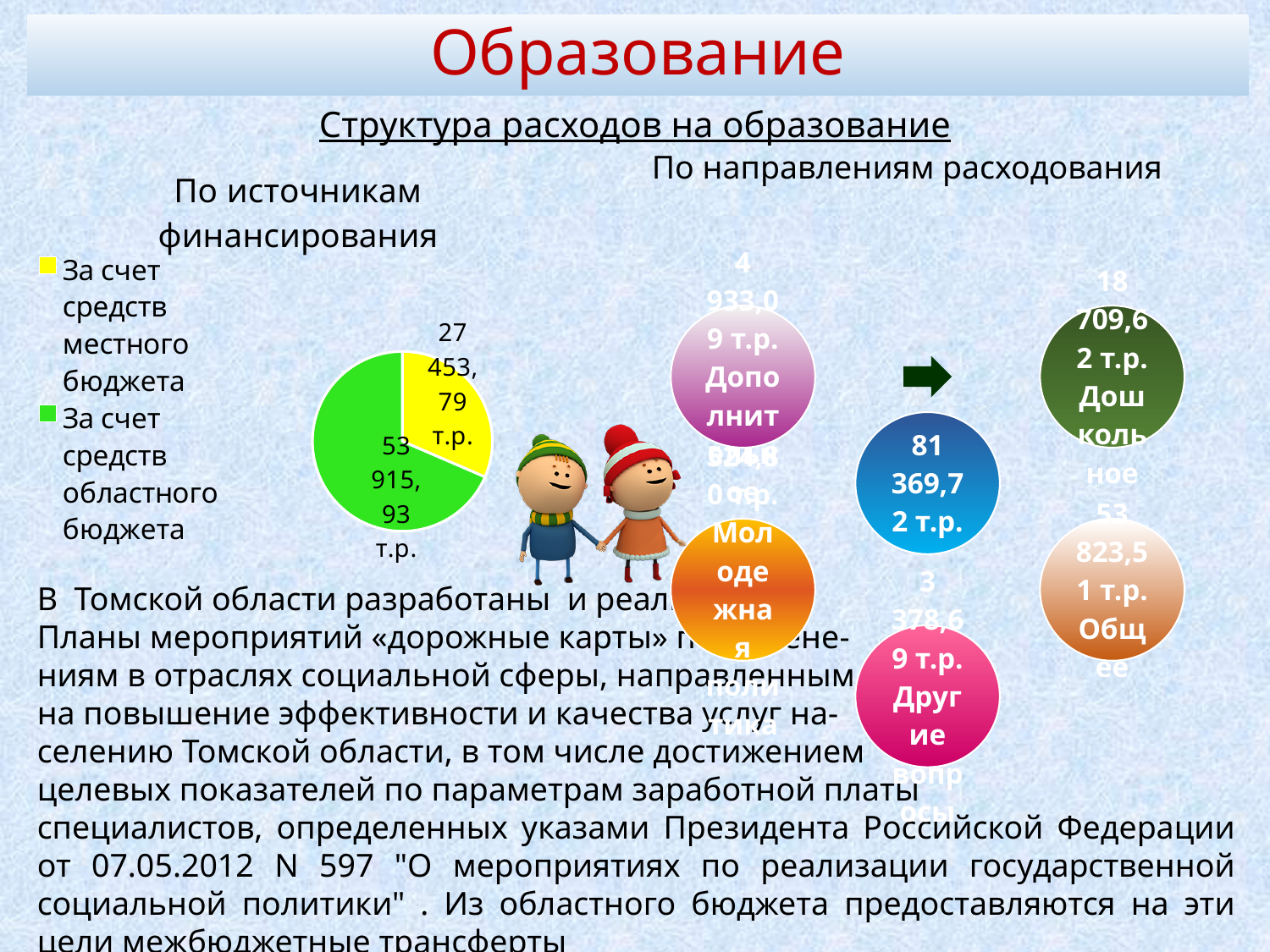
What is the title of the pie chart on the left of the slide? По источникам финансирования How many entries does the legend of the "По источникам финансирования" pie chart list? 2 In the "По источникам финансирования" pie chart, what is the total of the two slices? 81 369,72 т.р. In the "По источникам финансирования" pie chart, what is the value for "За счет средств областного бюджета"? 53 915,93 т.р. In the "По источникам финансирования" pie chart, which source of funding has the largest value? За счет средств областного бюджета What kind of chart is the "По источникам финансирования" chart on the left of the slide? pie chart How many slices does the "По источникам финансирования" pie chart have? 2 In the "По источникам финансирования" pie chart, what colour is the slice for "За счет средств местного бюджета"? yellow In the "По источникам финансирования" pie chart, what is the value for "За счет средств местного бюджета"? 27 453,79 т.р. In the "По источникам финансирования" pie chart, which is larger: the local budget (местного бюджета) value or the regional budget (областного бюджета) value? областного бюджета In the "По источникам финансирования" pie chart, which source of funding has the smallest value? За счет средств местного бюджета In the "По источникам финансирования" pie chart, what is the difference between the regional budget value and the local budget value? 26 462,14 т.р.